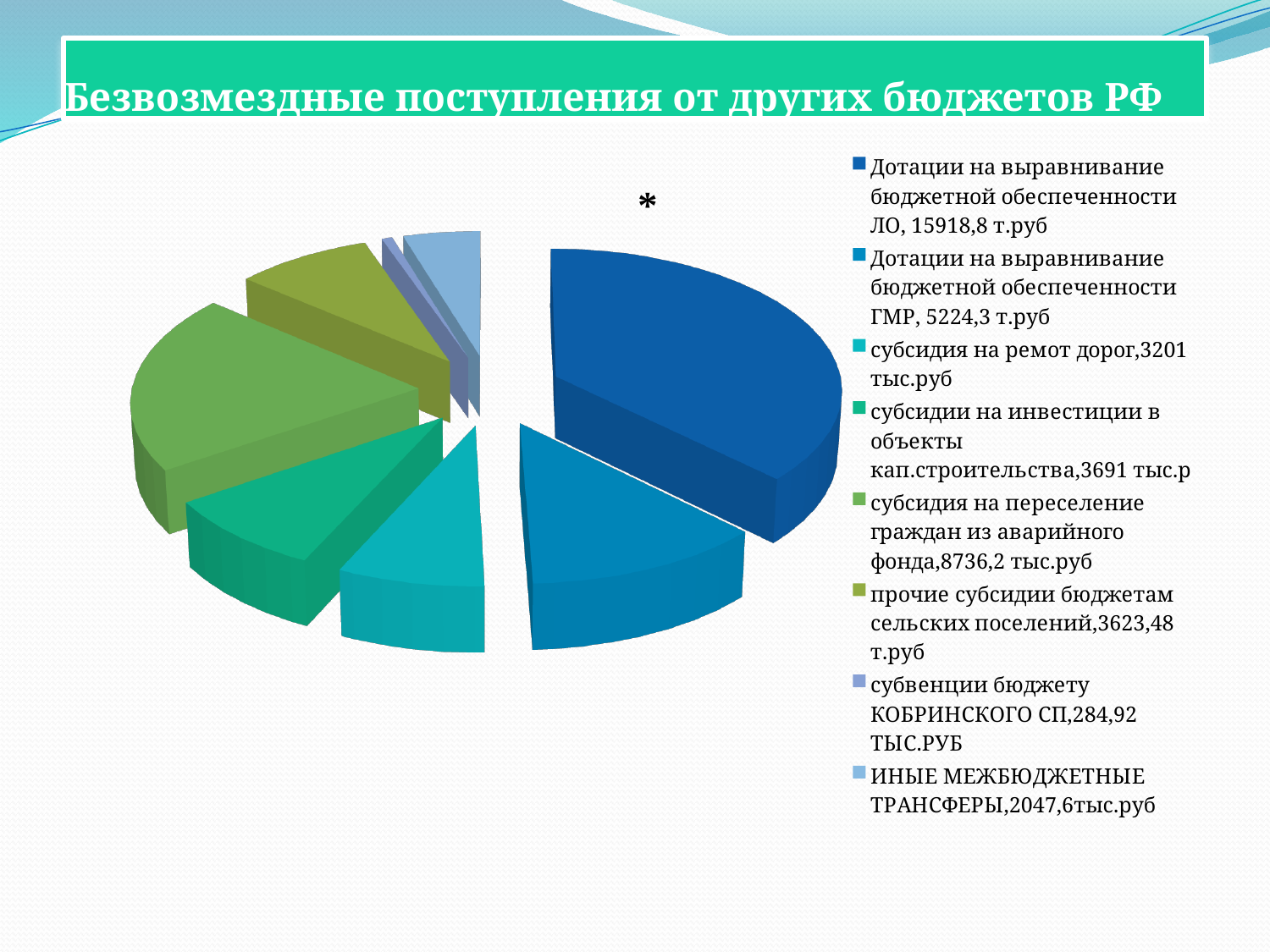
What type of chart is shown on the slide? pie chart Which is larger: 'субсидии на инвестиции в объекты кап.строительства' or 'субсидия на ремот дорог'? субсидии на инвестиции в объекты кап.строительства What is the value for 'субсидия на переселение граждан из аварийного фонда'? 8736,2 тыс.руб What is the value for 'ИНЫЕ МЕЖБЮДЖЕТНЫЕ ТРАНСФЕРЫ'? 2047,6 тыс.руб How many slices (categories) does the pie chart have? 8 Which category has the largest value in the pie chart? Дотации на выравнивание бюджетной обеспеченности ЛО What is the difference between 'Дотации на выравнивание бюджетной обеспеченности ГМР' (5224,3) and 'субсидия на ремот дорог' (3201)? 2023,3 What is the value for 'субвенции бюджету КОБРИНСКОГО СП'? 284,92 ТЫС.РУБ What is the difference between 'Дотации на выравнивание бюджетной обеспеченности ЛО' (15918,8) and 'субсидия на переселение граждан из аварийного фонда' (8736,2)? 7182,6 Which category has the smallest value in the pie chart? субвенции бюджету КОБРИНСКОГО СП What is the value for 'Дотации на выравнивание бюджетной обеспеченности ЛО'? 15918,8 т.руб What is the title of the slide containing the pie chart? Безвозмездные поступления от других бюджетов РФ